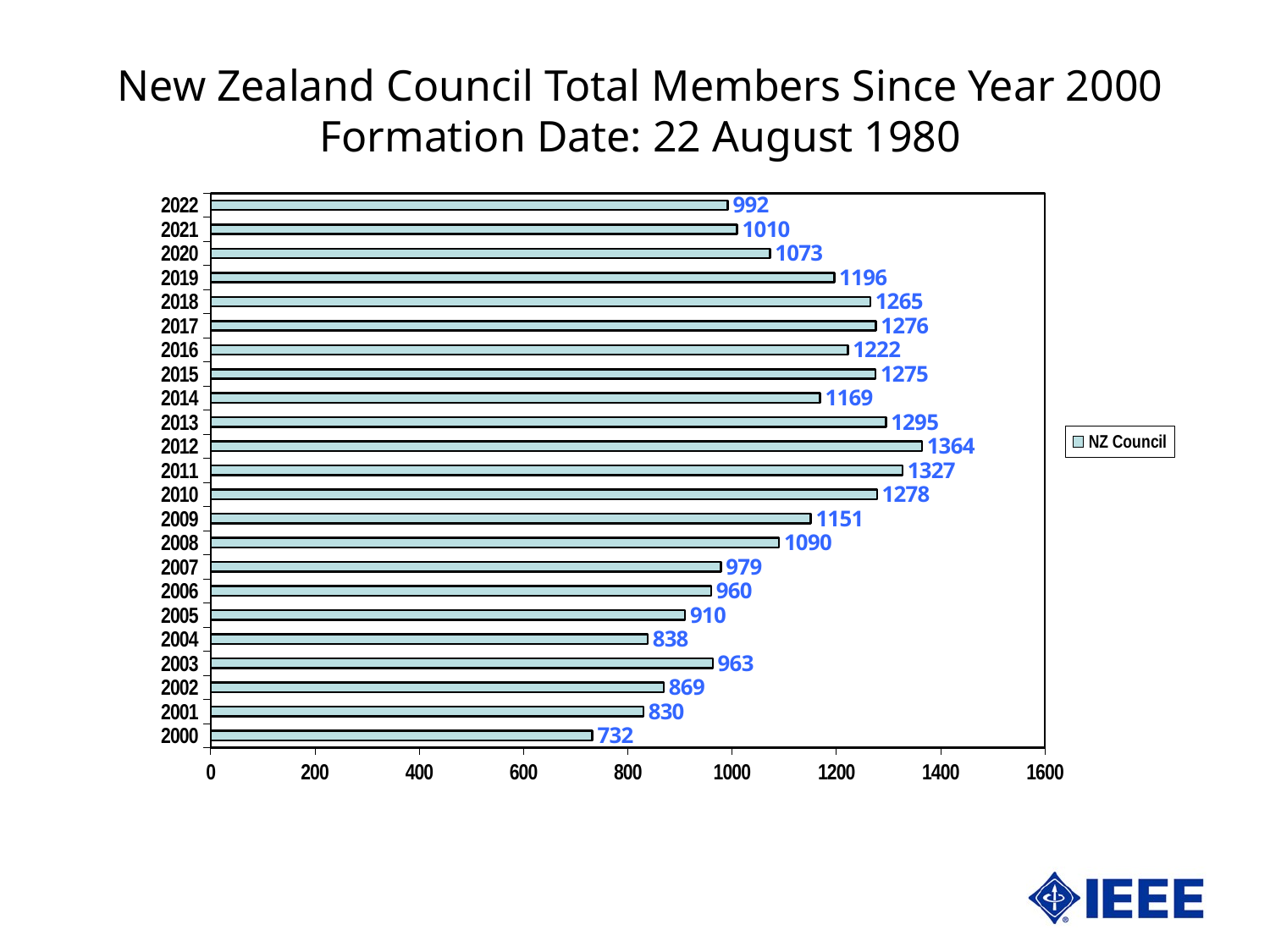
What is the difference between the values for 2012 and 2000? 632 How many series does the legend list? 1 Which year has the highest value? 2012 What is the value for 2022? 992 What is the name of the series in the legend? NZ Council Which year has the lowest value? 2000 How many years are shown on the chart? 23 Is the value for 2013 greater or less than 1200? greater What is the value for 2012? 1364 Which is larger, the value for 2016 or the value for 2019? 2016 What is the value for 2000? 732 What kind of chart is shown? bar chart